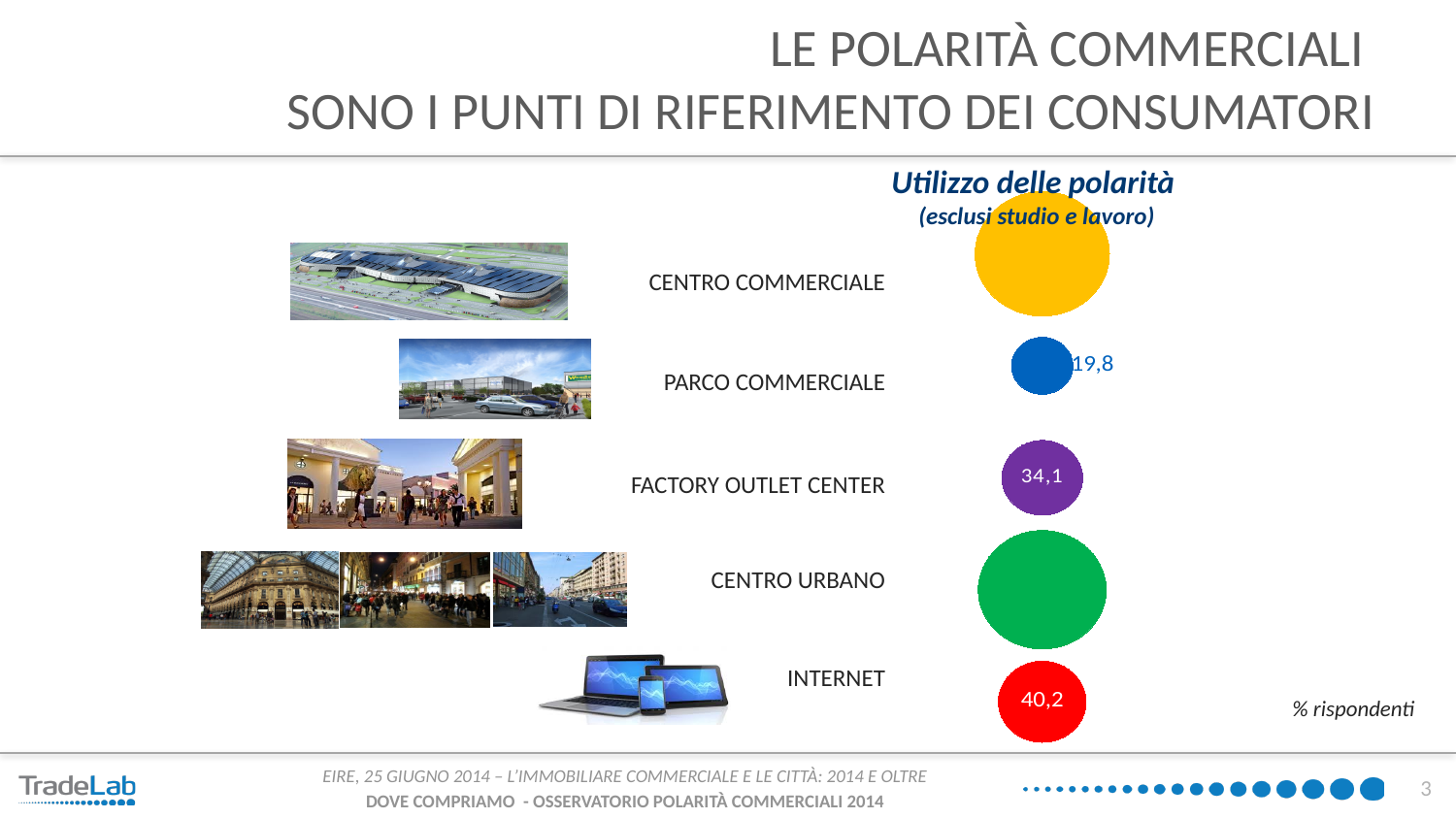
Which has a higher value, INTERNET or FACTORY OUTLET CENTER? INTERNET Which category has the smallest bubble in the 'Utilizzo delle polarità' chart? PARCO COMMERCIALE What is the difference between the values for FACTORY OUTLET CENTER and PARCO COMMERCIALE? 14,3 What kind of chart is used to show 'Utilizzo delle polarità'? Bubble chart What is the difference between the values for INTERNET and PARCO COMMERCIALE? 20,4 What is the difference between the values for INTERNET and FACTORY OUTLET CENTER? 6,1 What is the value for PARCO COMMERCIALE in the 'Utilizzo delle polarità' chart? 19,8 What is the value for INTERNET in the 'Utilizzo delle polarità' chart? 40,2 What is the value for FACTORY OUTLET CENTER in the 'Utilizzo delle polarità' chart? 34,1 How many categories are shown in the 'Utilizzo delle polarità' chart? 5 What unit is indicated for the values in the chart? % rispondenti